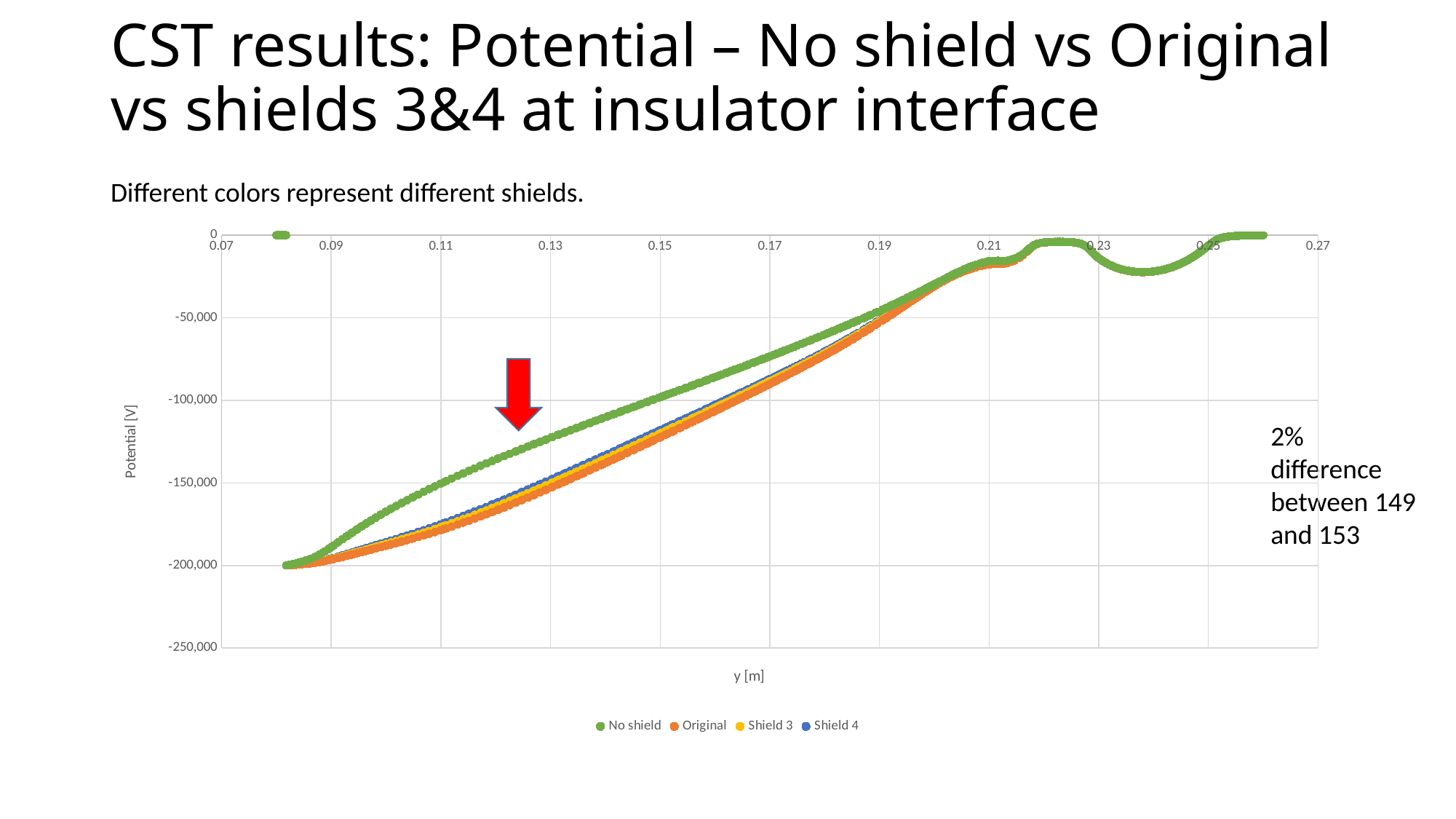
At y = 0.17 m, is the potential for the No shield series greater or less than -100,000? greater At y = 0.09 m, is the potential for the No shield series greater or less than -150,000? less What is the label of the vertical axis of the chart? Potential [V] Which series has the highest (least negative) potential at y = 0.13 m? No shield At y = 0.13 m, which series has the higher (less negative) potential, No shield or Original? No shield How many series does the chart legend list? 4 At y = 0.13 m, is the potential for the No shield series greater or less than -150,000? greater Do the plotted potential values rise or fall as y [m] increases from 0.08 to 0.22? Rise What are the series names listed in the chart legend? No shield, Original, Shield 3, Shield 4 What kind of chart is shown on the slide? Scatter (line) chart